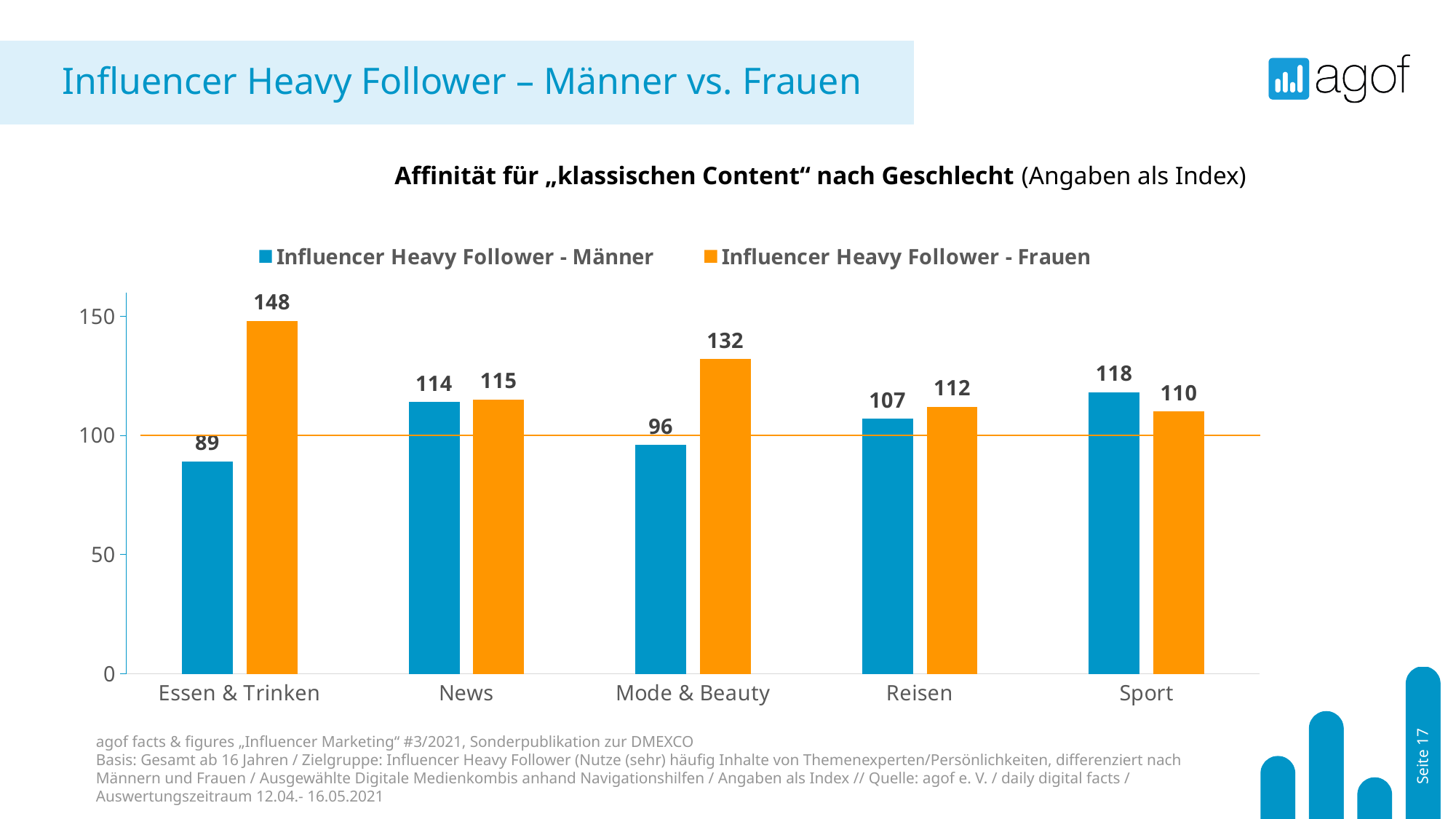
How many categories are shown on the x axis? 5 What is the value for Influencer Heavy Follower - Frauen in the Essen & Trinken category? 148 Which category has the lowest value for Influencer Heavy Follower - Männer? Essen & Trinken Which colour represents the Influencer Heavy Follower - Frauen series? Orange What kind of chart is shown on the slide? Bar chart What is the difference between the Frauen and Männer values in the Mode & Beauty category? 36 What is the value for Influencer Heavy Follower - Männer in the Mode & Beauty category? 96 In the Sport category, which series has the larger value, Männer or Frauen? Influencer Heavy Follower - Männer How many series does the legend list? 2 What is the value for Influencer Heavy Follower - Männer in the Sport category? 118 What is the difference between the Frauen and Männer values in the Essen & Trinken category? 59 Which category has the highest value for Influencer Heavy Follower - Frauen? Essen & Trinken